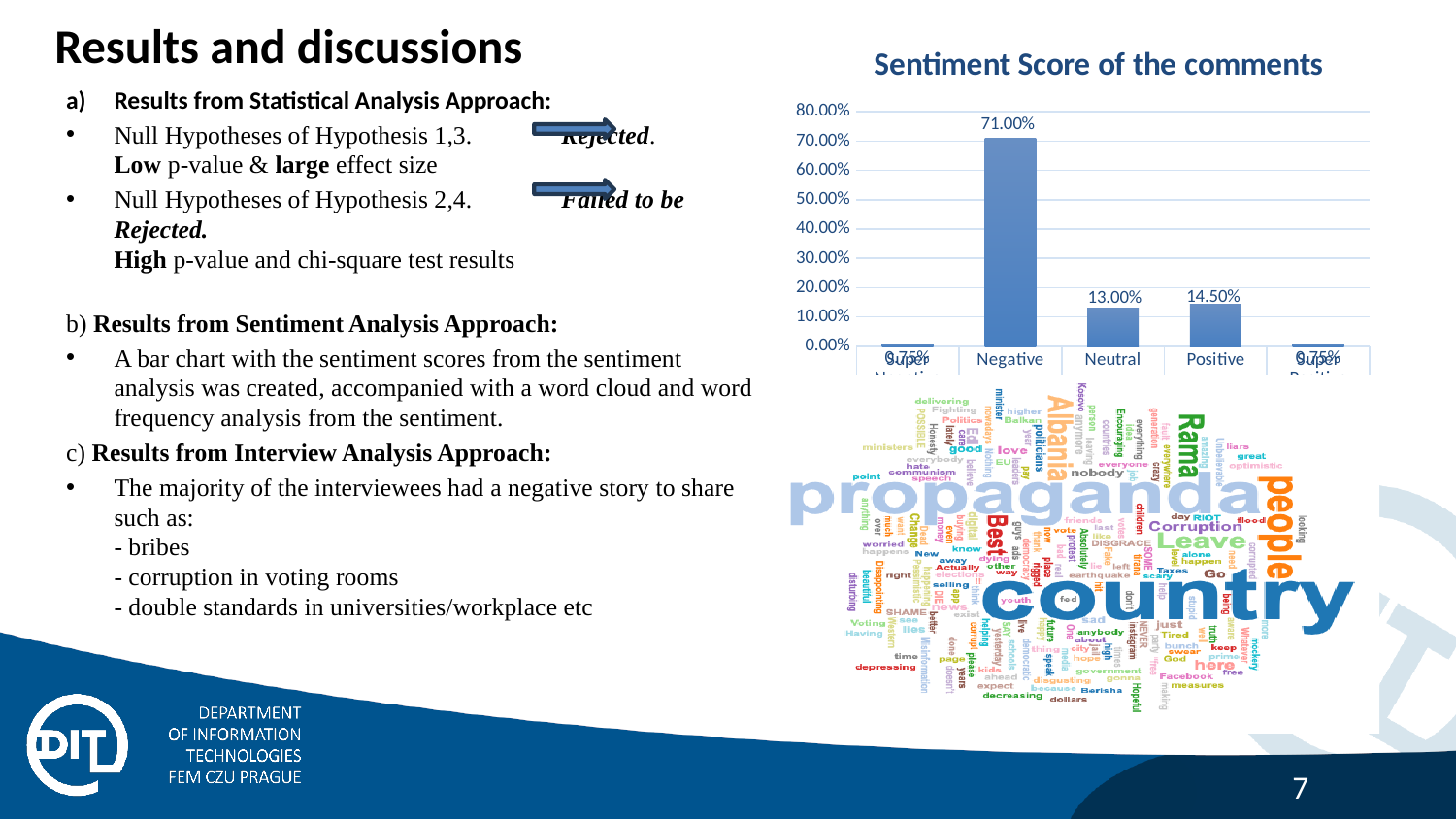
In the 'Sentiment Score of the comments' chart, what is the difference between the Negative and Neutral values? 58.00% What kind of chart is the 'Sentiment Score of the comments' chart? bar chart What is the title of the chart on the slide? Sentiment Score of the comments In the 'Sentiment Score of the comments' chart, which is larger, Positive or Neutral? Positive In the 'Sentiment Score of the comments' chart, which category has the highest value? Negative In the 'Sentiment Score of the comments' chart, what is the difference between the Positive and Neutral values? 1.50% In the 'Sentiment Score of the comments' chart, what is the value for Negative? 71.00% In the 'Sentiment Score of the comments' chart, is the value for Neutral greater or less than 20.00%? less In the 'Sentiment Score of the comments' chart, what is the value for Neutral? 13.00% How many categories are shown in the 'Sentiment Score of the comments' chart? 5 In the 'Sentiment Score of the comments' chart, what is the value for Positive? 14.50% In the 'Sentiment Score of the comments' chart, is the value for Negative greater or less than 70.00%? greater